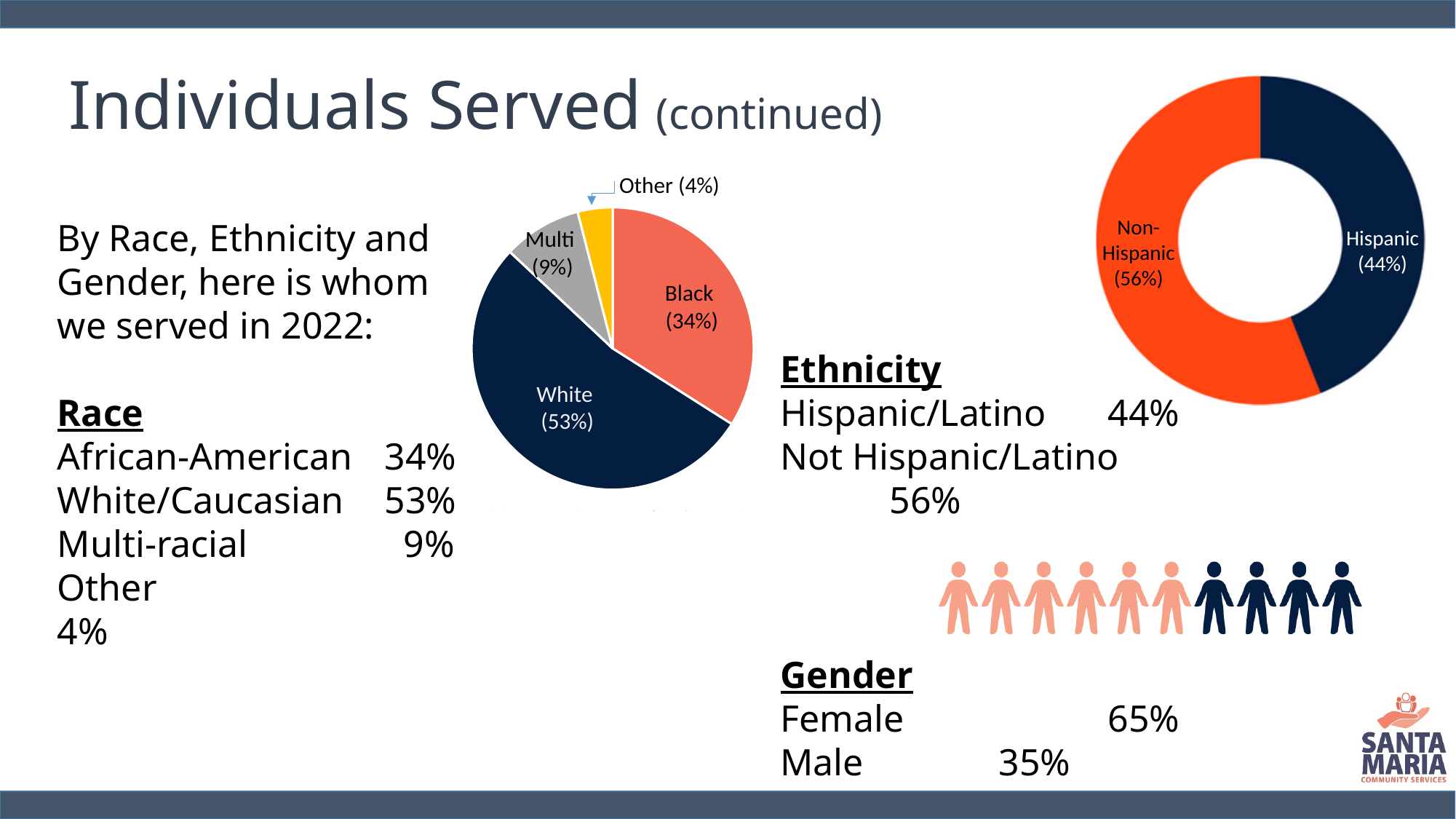
In the pie chart in the middle of the slide, which category has the largest slice? White In the pie chart in the middle of the slide, how many slices are there? 4 In the donut chart on the right of the slide, what share is labelled for Hispanic? 44% In the pie chart in the middle of the slide, what is the difference in percentage points between the White and Black slices? 19 In the donut chart on the right of the slide, which segment is larger, Hispanic or Non-Hispanic? Non-Hispanic In the pie chart in the middle of the slide, what share is labelled for Black? 34% In the pie chart in the middle of the slide, what share is labelled for White? 53% In the donut chart on the right of the slide, what colour is the Non-Hispanic segment? Orange In the pie chart in the middle of the slide, which category has the smallest slice? Other What kind of chart is the chart in the middle of the slide showing race? Pie chart In the pie chart in the middle of the slide, what share is labelled for Multi? 9% In the pie chart in the middle of the slide, which slice is larger, Multi or Other? Multi